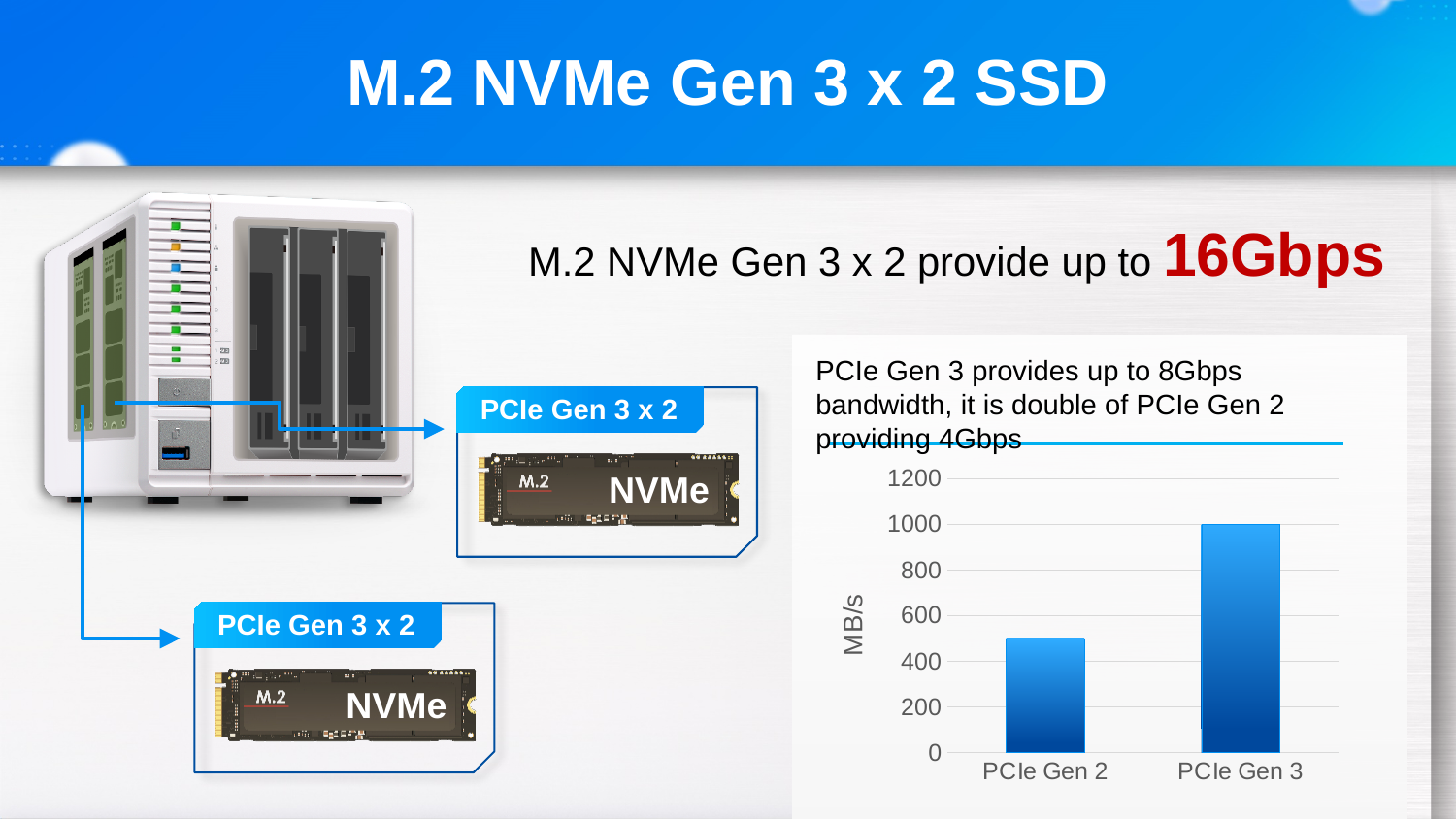
What kind of chart is shown on the slide? bar chart Is the value for PCIe Gen 3 greater or less than 800? greater Which is larger in the chart, the value for PCIe Gen 2 or PCIe Gen 3? PCIe Gen 3 Is the value for PCIe Gen 2 greater or less than 600? less How many categories does the bar chart show? 2 What is the label on the vertical axis of the chart? MB/s Is the value for PCIe Gen 3 greater or less than 1200? less Which category has the highest bar in the chart? PCIe Gen 3 Which category has the lowest bar in the chart? PCIe Gen 2 What is the highest tick value shown on the vertical axis of the chart? 1200 What value does the PCIe Gen 3 bar reach on the y axis? 1000